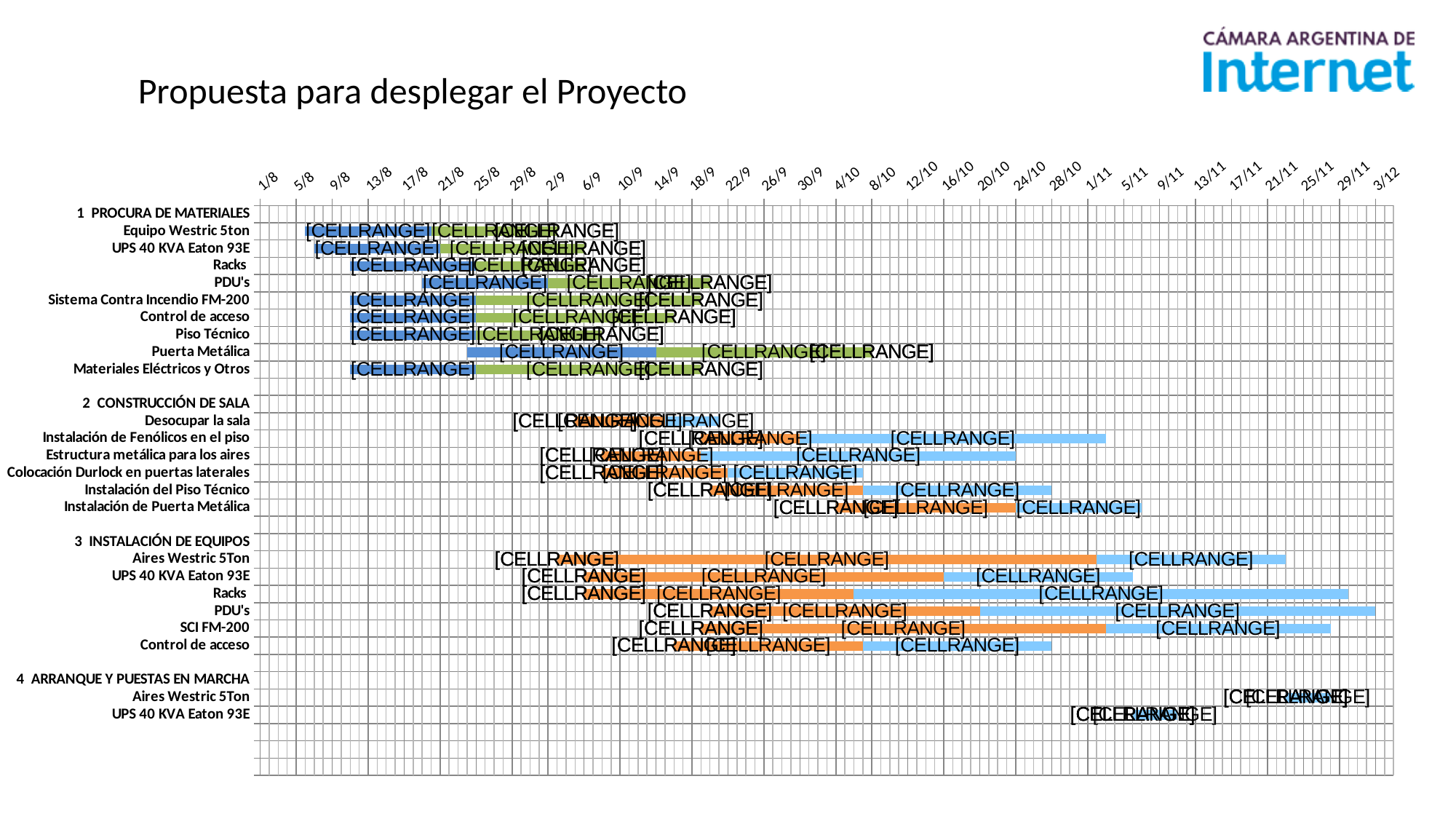
What kind of chart is shown on the slide? bar chart (Gantt) How many numbered sections (phases) are listed down the left side of the chart? 4 What is the first date shown on the horizontal axis? 1/8 What is the last date shown on the horizontal axis? 3/12 Which task in section 1 PROCURA DE MATERIALES has the bar that extends furthest to the right? Puerta Metálica How many tasks are listed under section 3 INSTALACIÓN DE EQUIPOS? 6 Which task in section 3 INSTALACIÓN DE EQUIPOS has the bar that extends furthest to the right? PDU's How many tasks are listed under section 4 ARRANQUE Y PUESTAS EN MARCHA? 2 Which task has the bar that starts earliest on the timeline? Equipo Westric 5ton